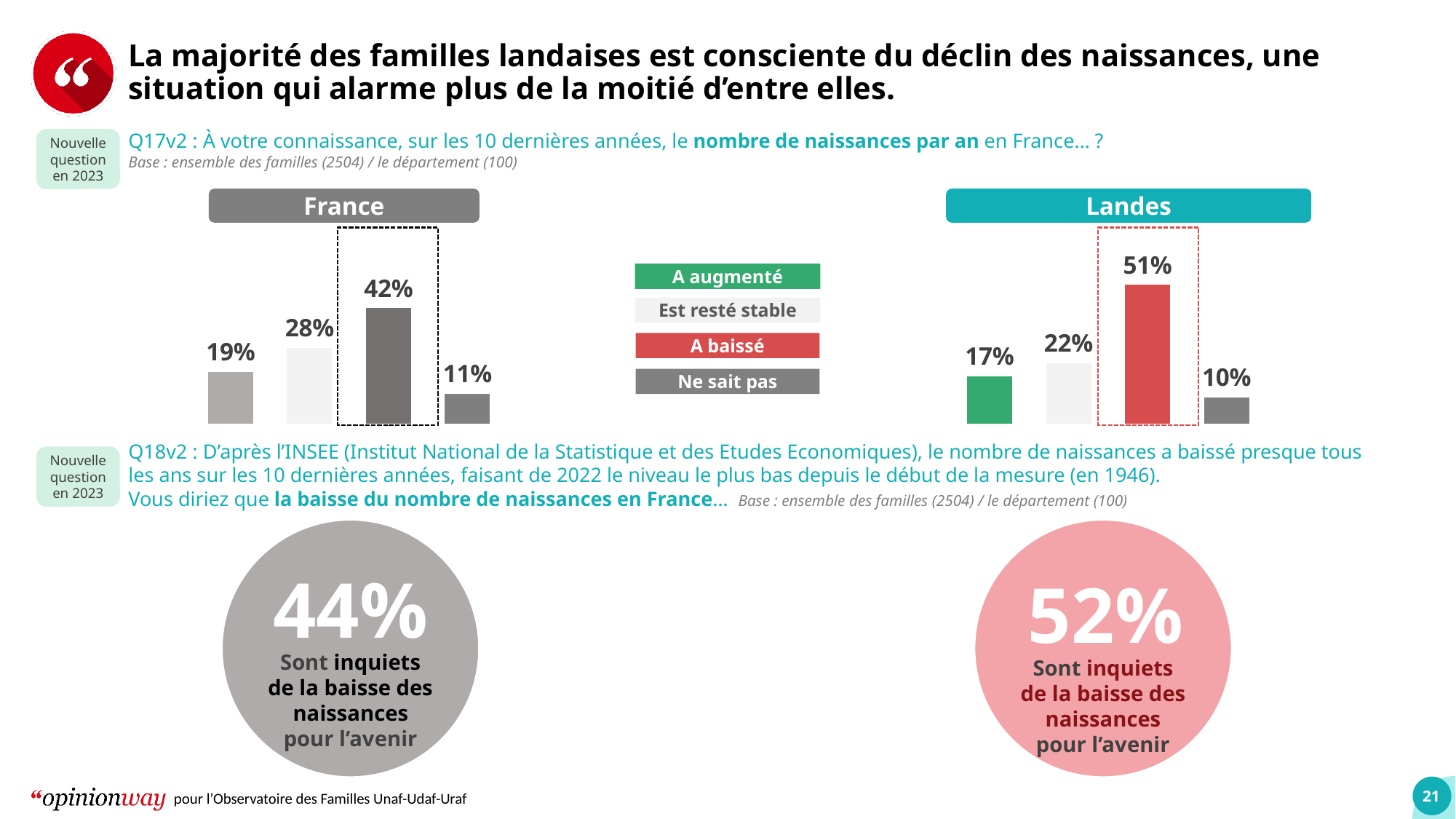
In the Landes chart, what percentage answered 'A augmenté'? 17% What is the difference between the 'Ne sait pas' percentage in the France chart and in the Landes chart? 1 point Which is larger: the 'Est resté stable' percentage in the France chart or in the Landes chart? France (28%) In the France chart, what percentage of families said the number of births per year 'A baissé'? 42% What type of chart is used to show the France and Landes results for Q17v2? Bar chart In the Landes chart, which response has the highest percentage? A baissé In the France chart, which response has the lowest percentage? Ne sait pas What is the difference between the 'A baissé' percentage in the Landes chart and in the France chart? 9 points How many response categories are shown as bars in the France chart? 4 In the Landes chart, what percentage of families said the number of births per year 'A baissé'? 51% In the France chart, what percentage answered 'Ne sait pas'? 11% Which colour is used for the 'A baissé' bar in the Landes chart? Red